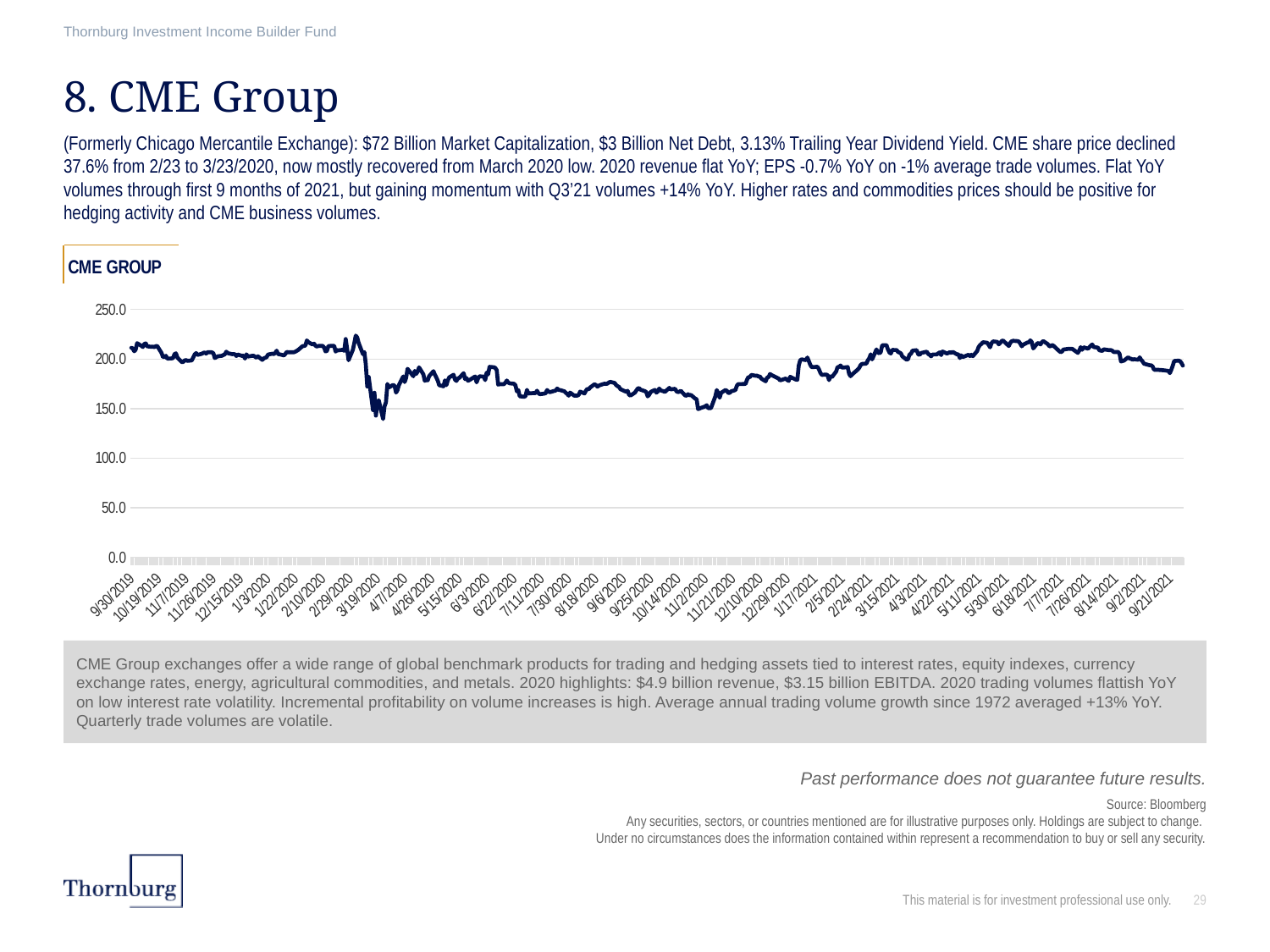
Is the value on 11/2/2020 greater or less than 200? less What is the highest value shown on the chart's vertical axis? 250.0 What kind of chart is shown on the slide? line chart What is the title of the chart? CME GROUP Which date shows a higher value, 3/19/2020 or 5/11/2021? 5/11/2021 Does the line generally rise or fall between 11/2/2020 and 5/11/2021? rise Is the value on 3/19/2020 greater or less than 200? less Is the value on 6/22/2020 greater or less than 200? less Does the line rise or fall between 2/29/2020 and 3/19/2020? fall How many data series are plotted in the chart? 1